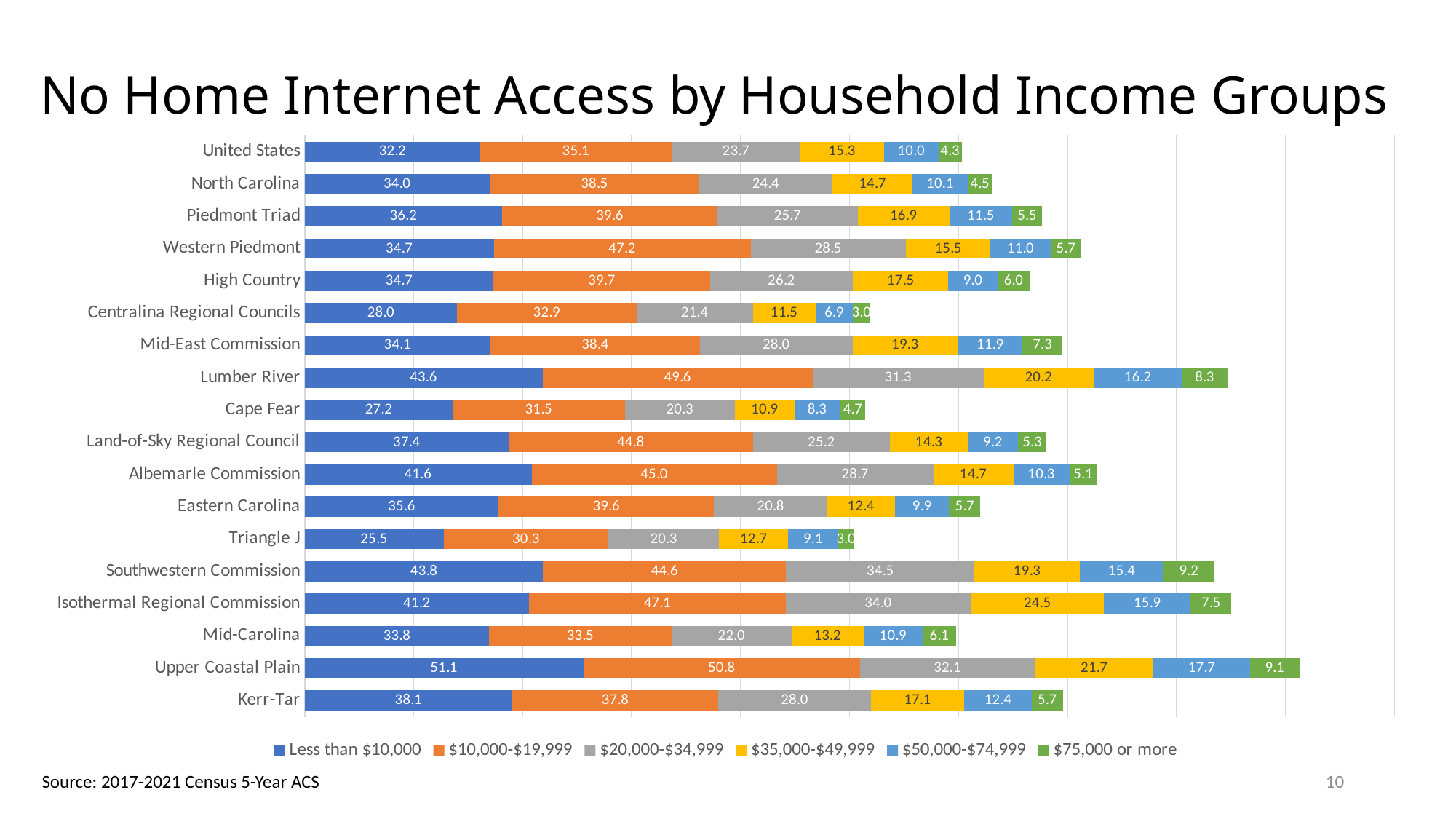
Which region has the lowest value in the Less than $10,000 series? Triangle J What is the total of the stacked bar for United States? 120.6 What kind of chart is shown on the slide? Stacked bar chart How many regions are shown on the chart? 18 What is the difference between the $10,000-$19,999 values for North Carolina and United States? 3.4 How many series does the legend list? 6 What is the value for the $50,000-$74,999 series for Lumber River? 16.2 What is the value for the Less than $10,000 series for United States? 32.2 Which region has the highest value in the Less than $10,000 series? Upper Coastal Plain Which has the larger $20,000-$34,999 value, Cape Fear or Mid-East Commission? Mid-East Commission What is the value for the $35,000-$49,999 series for Kerr-Tar? 17.1 What is the value for the $75,000 or more series for Upper Coastal Plain? 9.1